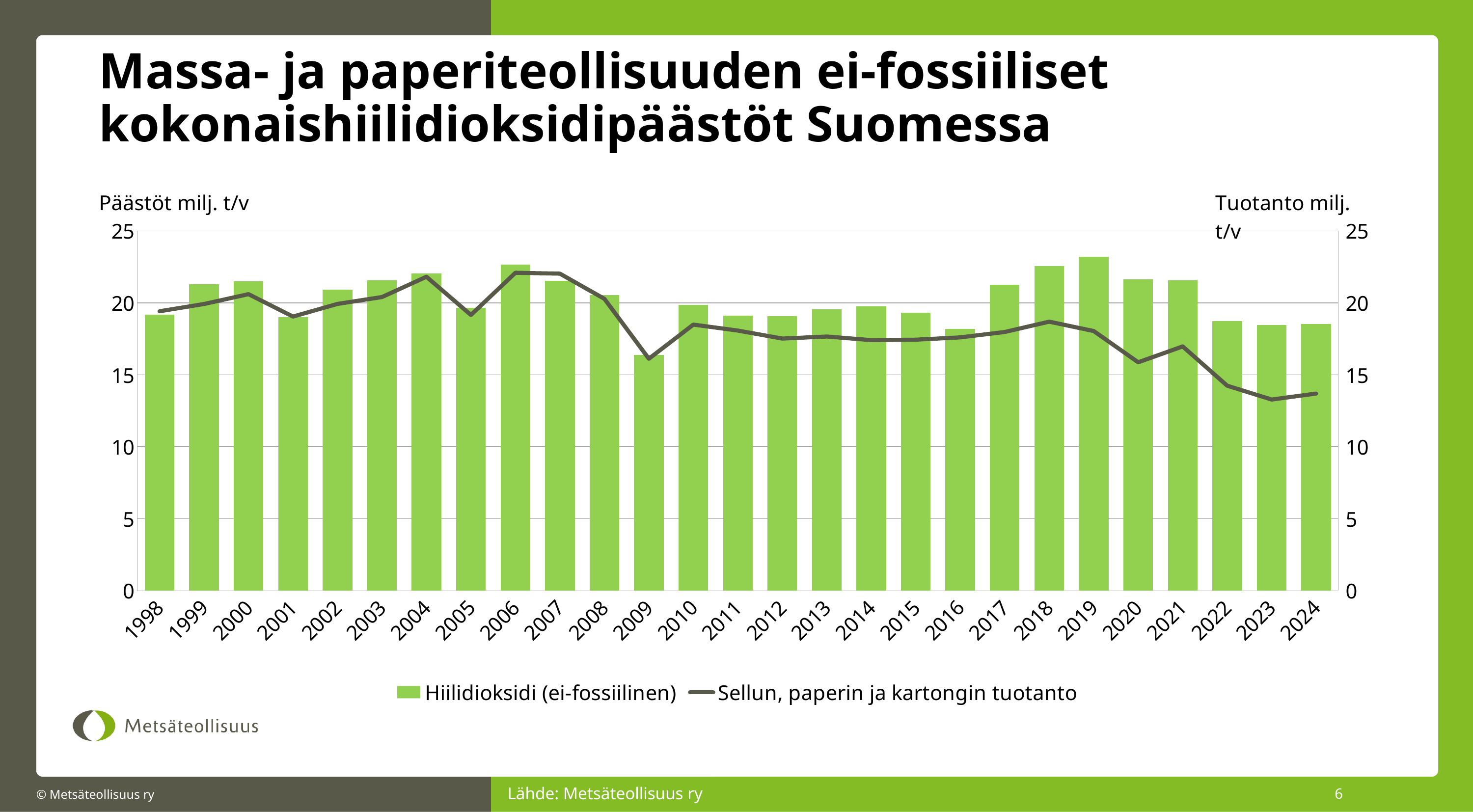
Is the Sellun, paperin ja kartongin tuotanto value for 2023 greater or less than 15? less How many years are shown on the x axis? 27 What kind of chart is shown on the slide? A combined bar and line chart Is the Hiilidioksidi (ei-fossiilinen) value for 2019 greater or less than 20? greater What is the label of the left vertical axis? Päästöt milj. t/v How many series does the legend list? 2 In which year is the Hiilidioksidi (ei-fossiilinen) bar the lowest? 2009 Does the Sellun, paperin ja kartongin tuotanto line rise or fall from 2019 to 2023? Fall What colour are the Hiilidioksidi (ei-fossiilinen) bars? Green In which year is the Hiilidioksidi (ei-fossiilinen) bar the highest? 2019 Is the Hiilidioksidi (ei-fossiilinen) value for 2009 greater or less than 20? less Which year has the larger Hiilidioksidi (ei-fossiilinen) bar, 2018 or 2016? 2018